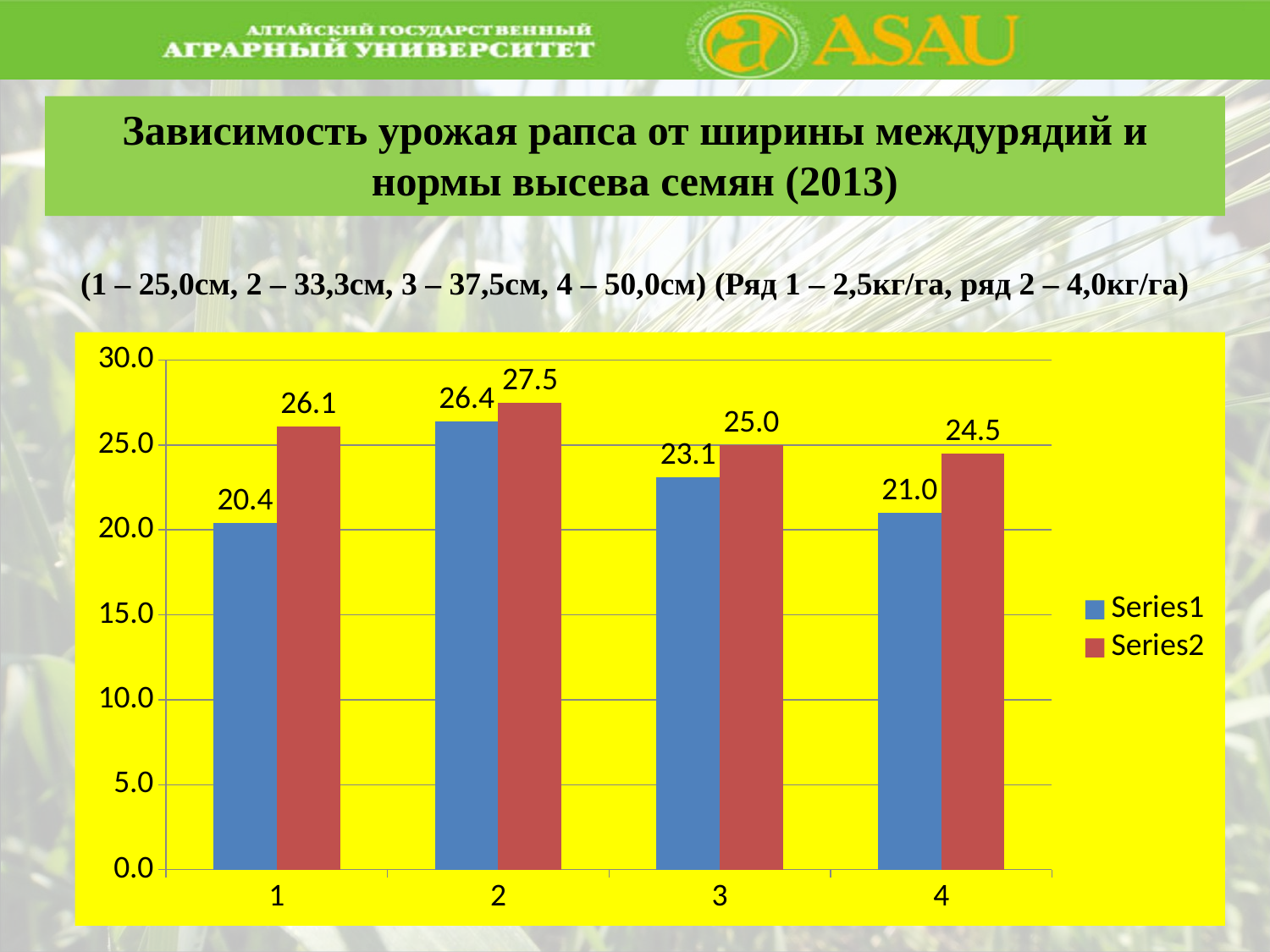
What is the value of Series1 for category 2? 26.4 What colour are the Series2 bars? Red Which is larger: Series1 for category 3 or Series1 for category 4? Series1 for category 3 What is the value of Series1 for category 1? 20.4 Which category has the highest Series2 value? 2 How many series does the legend list? 2 What is the difference between the Series1 values for category 2 and category 4? 5.4 What kind of chart is shown on the slide? Bar chart What is the value of Series2 for category 4? 24.5 What is the difference between Series2 and Series1 for category 1? 5.7 How many categories are shown on the x axis? 4 Which category has the lowest Series1 value? 1